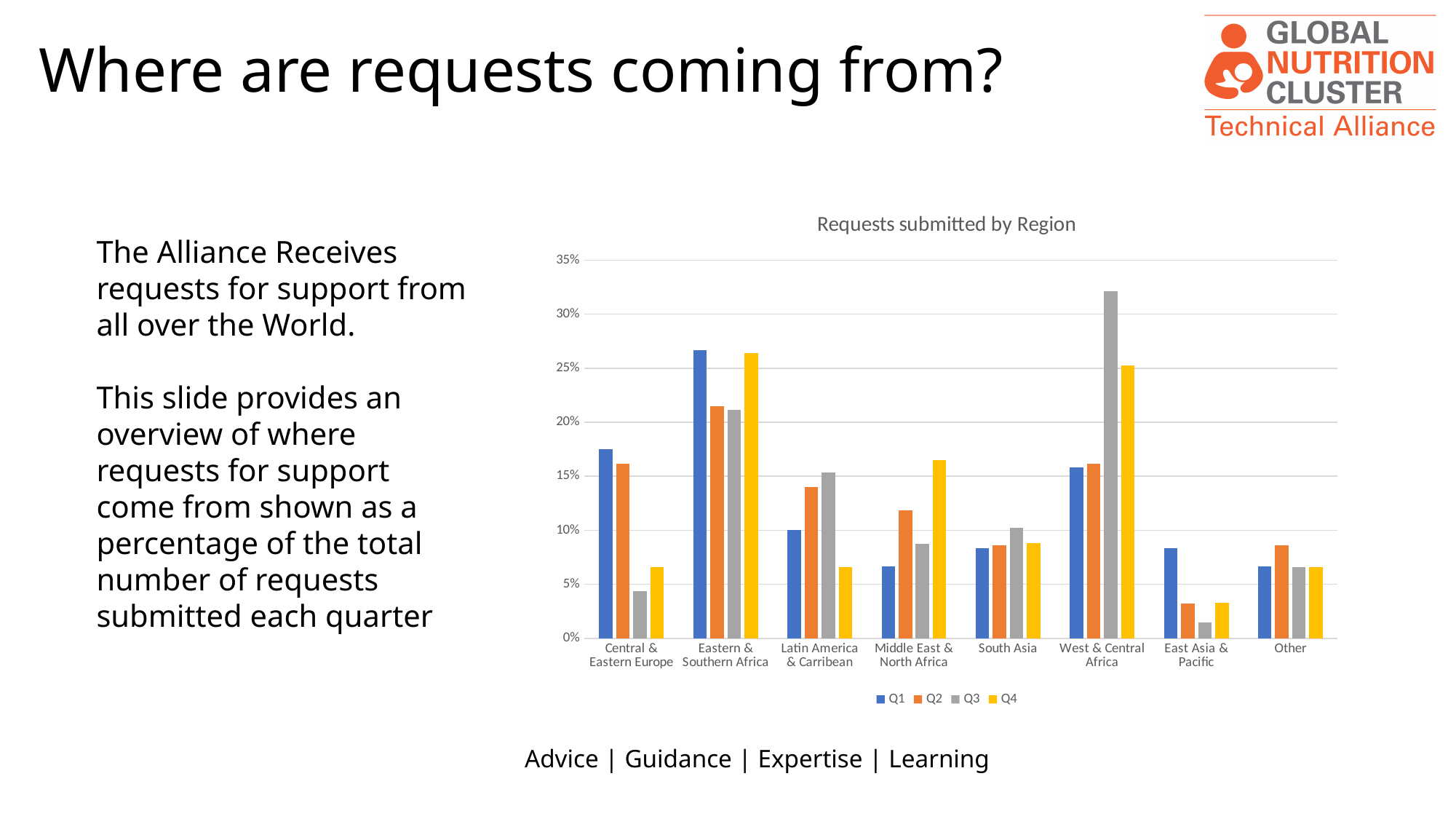
Which region has the shortest Q3 bar? East Asia & Pacific How many regions are shown on the x axis of the chart? 8 What is the title of the chart? Requests submitted by Region For Latin America & Carribean, which is larger: the Q3 value or the Q4 value? Q3 How many series does the chart's legend list? 4 Is the Q3 value for East Asia & Pacific greater or less than 5%? less Is the Q3 value for West & Central Africa greater or less than 30%? greater What kind of chart is shown on the slide? Bar chart For Middle East & North Africa, which is larger: the Q1 value or the Q4 value? Q4 Is the Q1 value for Central & Eastern Europe greater or less than 15%? greater Which region has the tallest Q1 bar? Eastern & Southern Africa Which region has the tallest Q3 bar? West & Central Africa